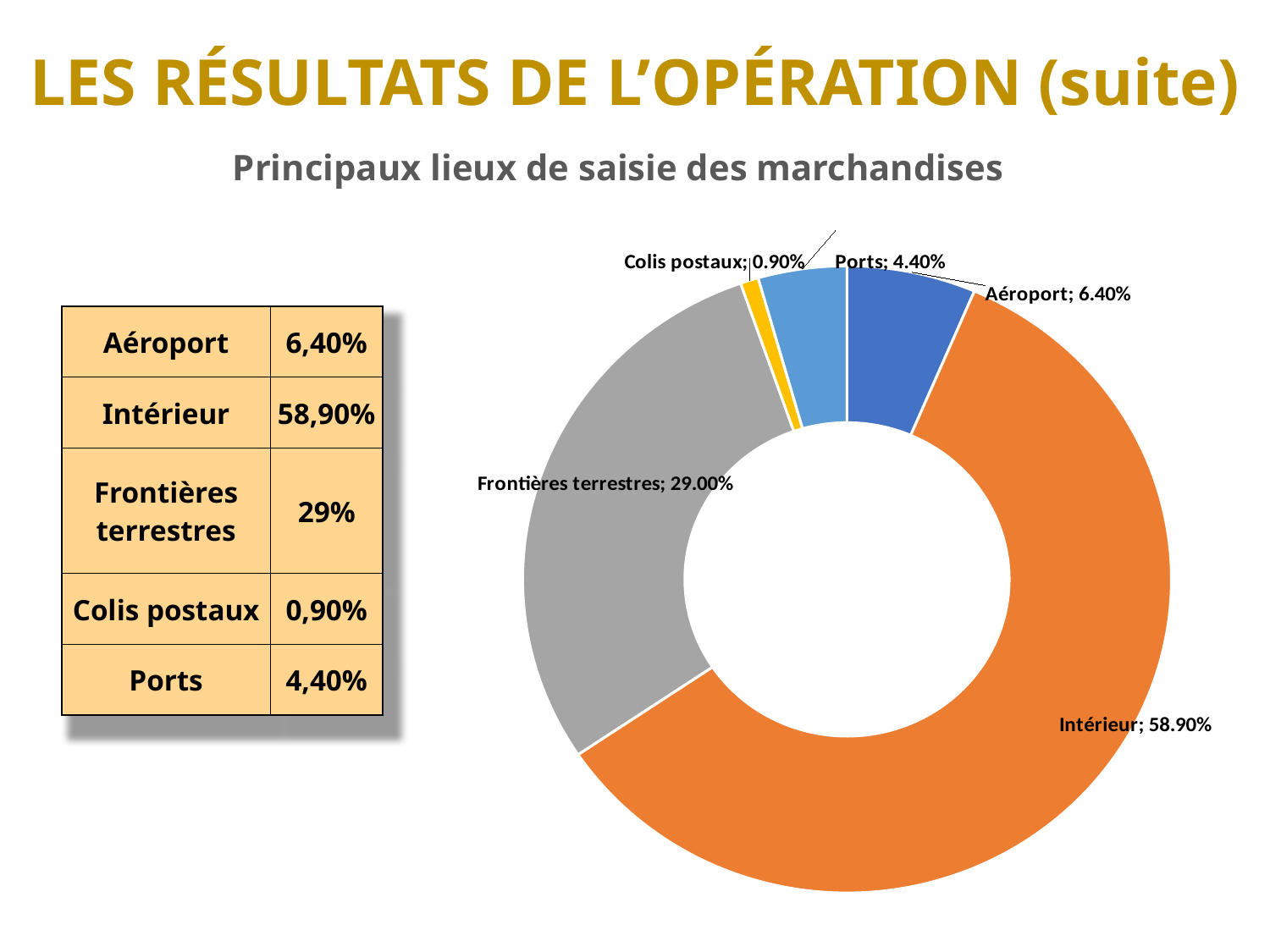
What is the value shown for Intérieur in the doughnut chart? 58.90% What is the value shown for Frontières terrestres in the chart? 29.00% Which category has the smallest share in the chart? Colis postaux What is the difference between the shares of Aéroport and Ports? 2.00% What colour is the Intérieur segment in the chart? orange What is the value shown for Colis postaux in the chart? 0.90% What is the difference between the shares of Intérieur and Frontières terrestres? 29.90% Which is larger in the chart, Aéroport or Ports? Aéroport How many categories are shown in the chart? 5 Which category has the largest share in the chart? Intérieur What kind of chart is shown on the slide? doughnut chart What is the value shown for Ports in the chart? 4.40%